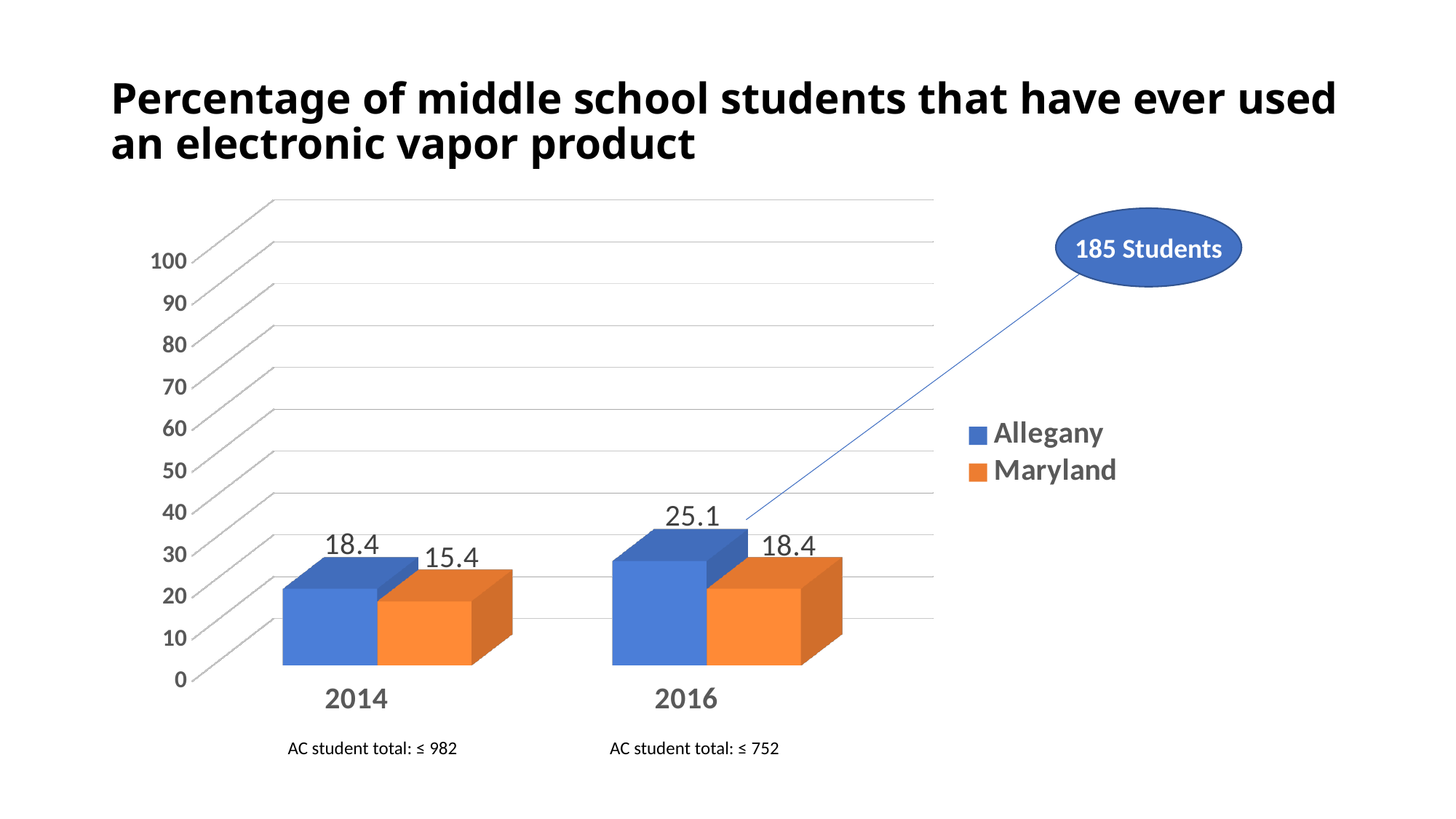
Is the value for Allegany in 2016 greater or less than 20? greater Which year has the highest value for Allegany? 2016 What kind of chart is shown on the slide? bar chart What is the value for Allegany in 2016? 25.1 How many series does the legend list? 2 What is the difference between the Allegany and Maryland values in 2016? 6.7 What is the value for Maryland in 2016? 18.4 What is the value for Allegany in 2014? 18.4 Do the Maryland values rise or fall from 2014 to 2016? rise What is the value for Maryland in 2014? 15.4 What is the difference between the Allegany values in 2016 and 2014? 6.7 Which is larger in 2014, the Allegany value or the Maryland value? Allegany